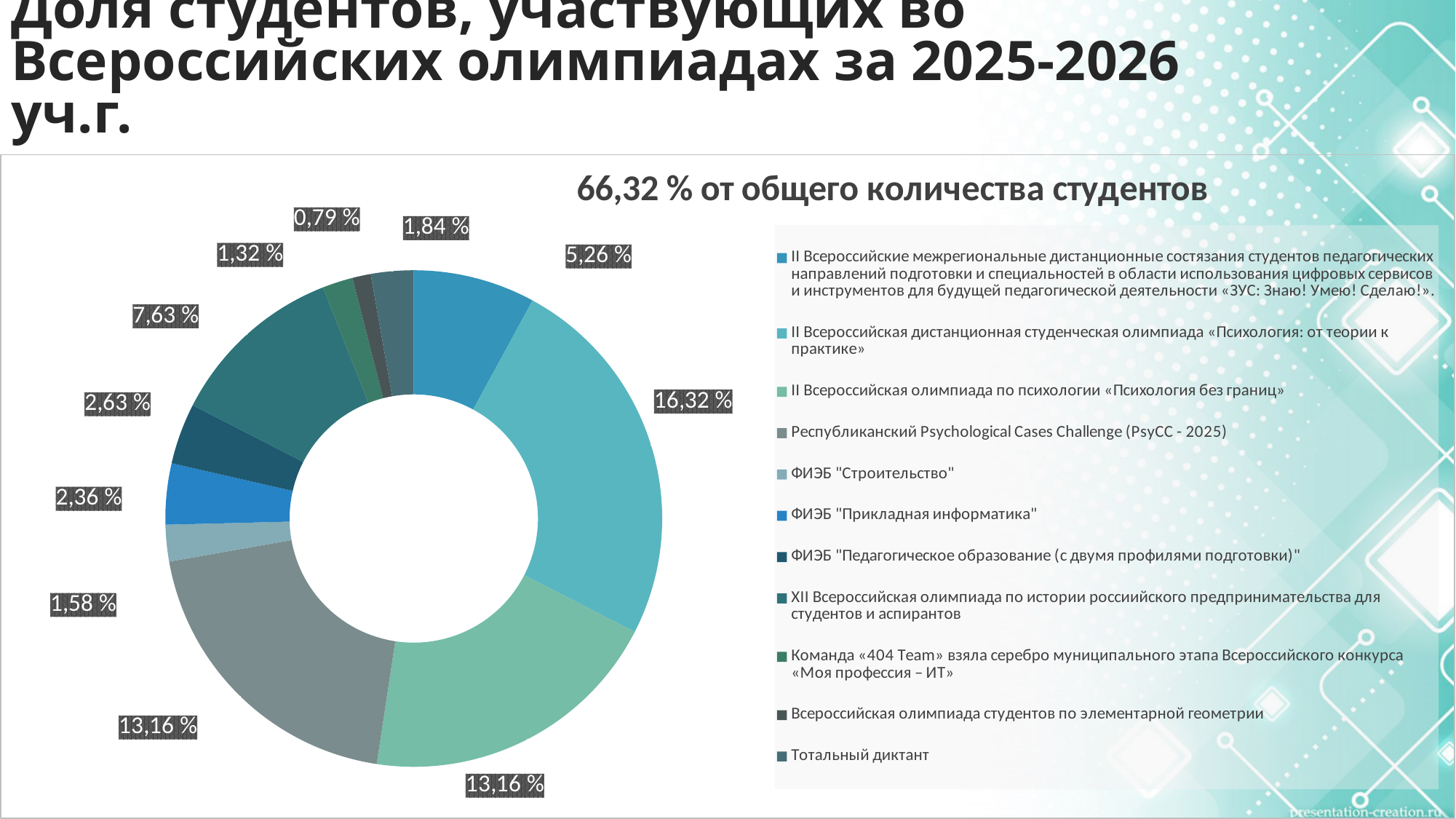
Which category has the smallest share of the chart? Всероссийская олимпиада студентов по элементарной геометрии What is the value for ФИЭБ "Прикладная информатика"? 2,36 % What is the value for «Тотальный диктант»? 1,84 % What is the value for «II Всероссийская дистанционная студенческая олимпиада «Психология: от теории к практике»»? 16,32 % What type of chart is shown on the slide? Doughnut (pie) chart What is the value for «XII Всероссийская олимпиада по истории российского предпринимательства для студентов и аспирантов»? 7,63 % What is the value for «Республиканский Psychological Cases Challenge (PsyCC - 2025)»? 13,16 % Which category has the largest share of the chart? II Всероссийская дистанционная студенческая олимпиада «Психология: от теории к практике» How many categories does the chart contain? 11 What is the chart's title? 66,32 % от общего количества студентов What is the difference between the value for «Психология: от теории к практике» (16,32 %) and the value for ФИЭБ "Строительство" (1,58 %)? 14,74 % Which is larger: the value for ФИЭБ "Педагогическое образование (с двумя профилями подготовки)" or the value for ФИЭБ "Прикладная информатика"? ФИЭБ "Педагогическое образование (с двумя профилями подготовки)"